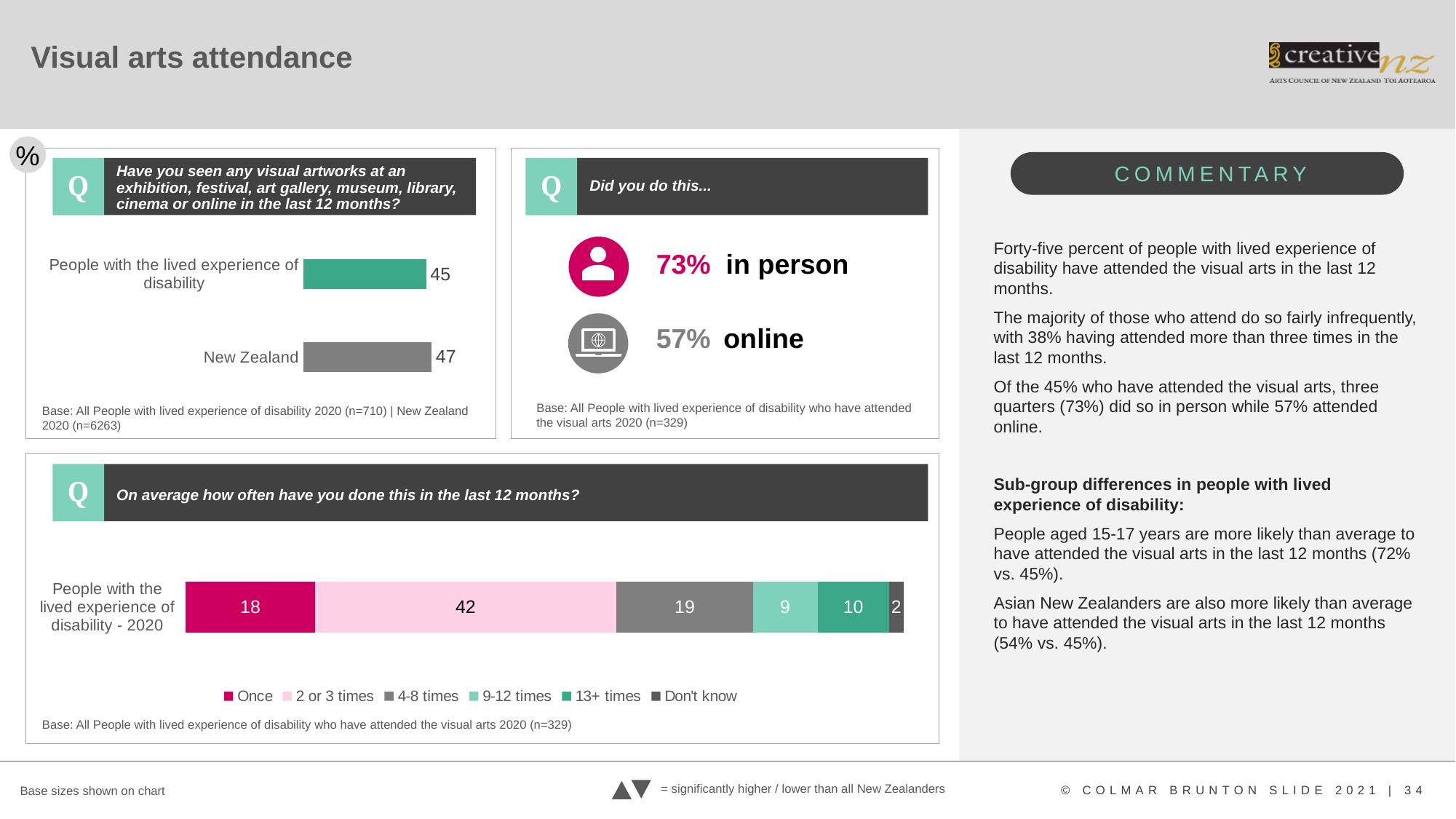
In the bottom chart on how often people have done this in the last 12 months, which segment is the largest? 2 or 3 times In the bottom chart on how often people have done this in the last 12 months, how many series does the legend list? 6 In the bottom chart on how often people have done this in the last 12 months, what is the value for '2 or 3 times'? 42 In the bottom chart on how often people have done this in the last 12 months, what is the value for 'Once'? 18 In the bottom chart on how often people have done this in the last 12 months, which segment is the smallest? Don't know What type of chart is the top-left chart on visual artworks seen in the last 12 months? Bar chart In the top-left chart on visual artworks seen in the last 12 months, how many categories are shown? 2 In the top-left chart on visual artworks seen in the last 12 months, what is the value for New Zealand? 47 In the top-left chart on visual artworks seen in the last 12 months, which category has the higher value? New Zealand In the bottom chart on how often people have done this in the last 12 months, what is the total of the stacked bar for People with the lived experience of disability - 2020? 100 In the top-left chart on visual artworks seen in the last 12 months, what is the value for People with the lived experience of disability? 45 In the top-left chart on visual artworks seen in the last 12 months, what is the difference between the New Zealand value and the value for People with the lived experience of disability? 2